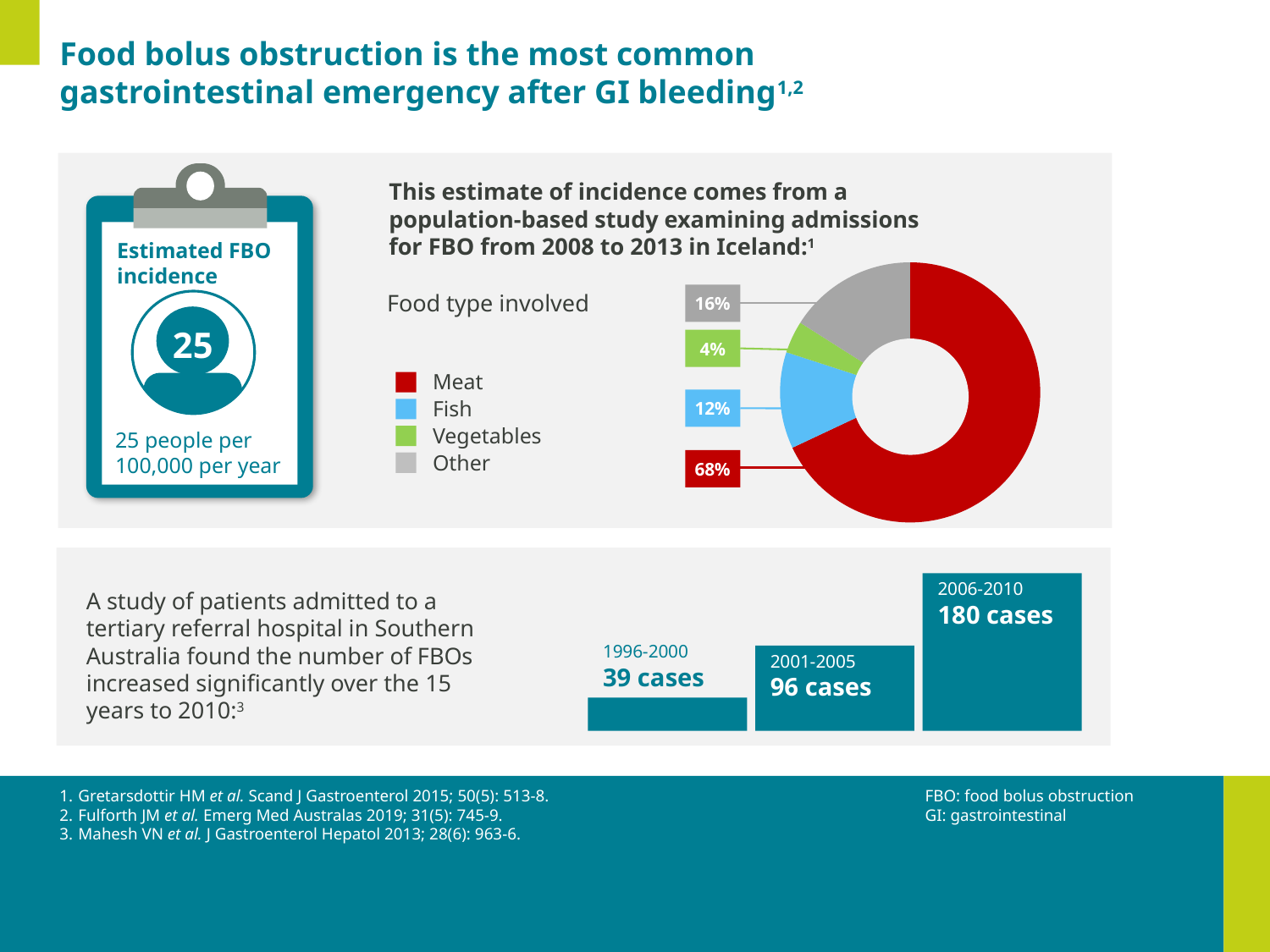
In the 'Food type involved' chart, which food type has the largest share? Meat In the 'Food type involved' chart, which food type has the smallest share? Vegetables In the 'Food type involved' chart, what percentage of cases involved meat? 68% In the 'Food type involved' chart, what percentage of cases involved fish? 12% In the 'Food type involved' chart, how many food types does the legend list? 4 What kind of chart is the 'Food type involved' chart? Donut (pie) chart In the 'Food type involved' chart, what percentage of cases involved vegetables? 4% In the bar chart of FBO cases in Southern Australia, how many more cases were there in 2006-2010 than in 1996-2000? 141 In the bar chart of FBO cases in Southern Australia, which period had the most cases? 2006-2010 In the bar chart of FBO cases in Southern Australia, do the number of cases rise or fall across the periods from 1996-2000 to 2006-2010? Rise In the bar chart of FBO cases in Southern Australia, how many cases were there in 2001-2005? 96 cases In the 'Food type involved' chart, what is the difference in percentage points between Other and Fish? 4